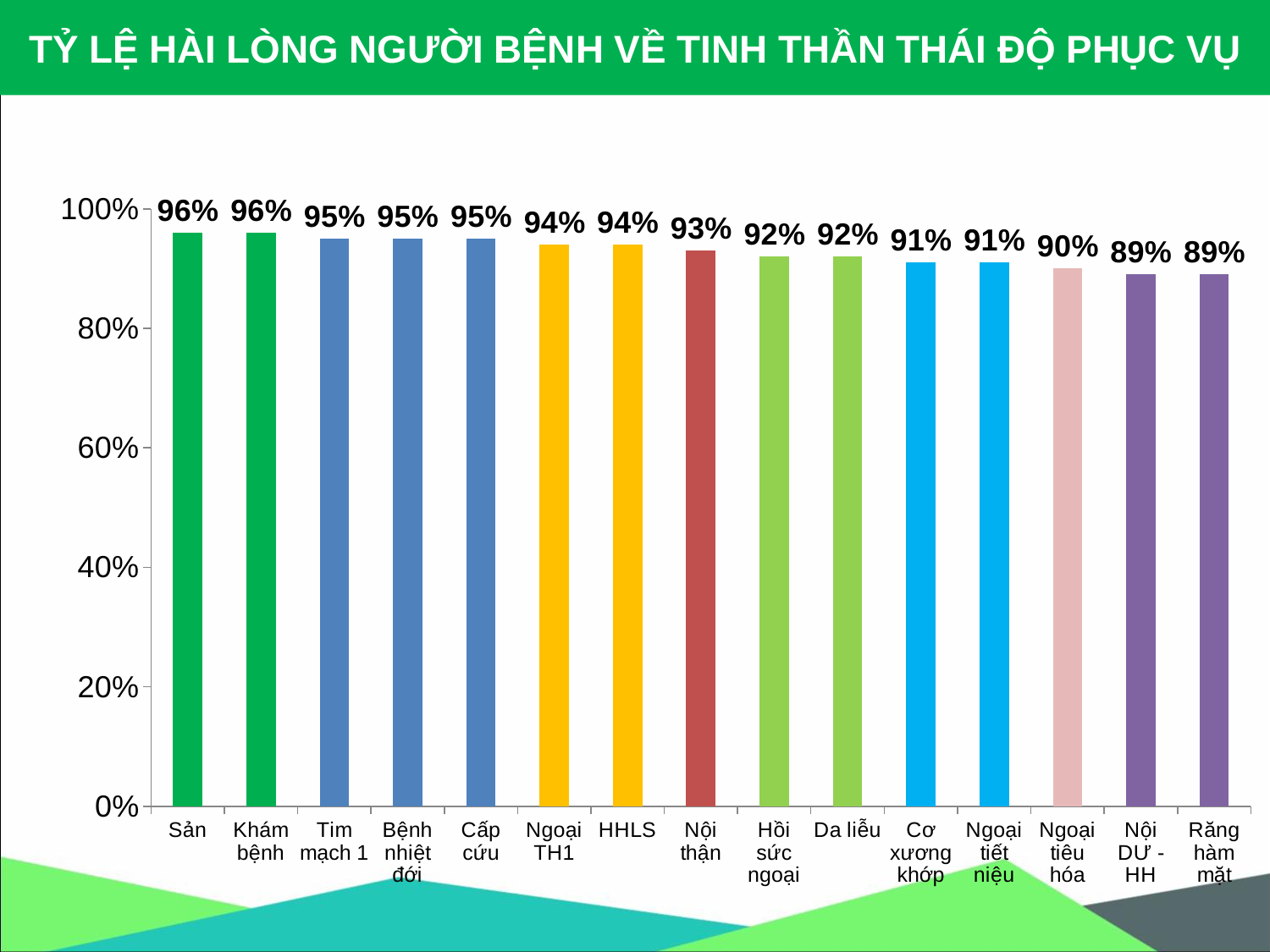
How many departments (bars) are shown on the chart? 15 Do the values rise or fall from left to right along the x axis? Fall What kind of chart is shown on the slide? Bar chart What value is shown for Ngoại tiêu hóa? 90% What is the highest value shown on the chart? 96% What is the satisfaction rate for Nội thận? 93% What is the value for HHLS? 94% What is the value for Cấp cứu? 95% What is the difference between the values for Sản and Răng hàm mặt? 7% Is the value for Răng hàm mặt greater or less than 80%? greater Which has a higher value, Nội thận or Ngoại tiêu hóa? Nội thận What is the lowest value shown on the chart? 89%